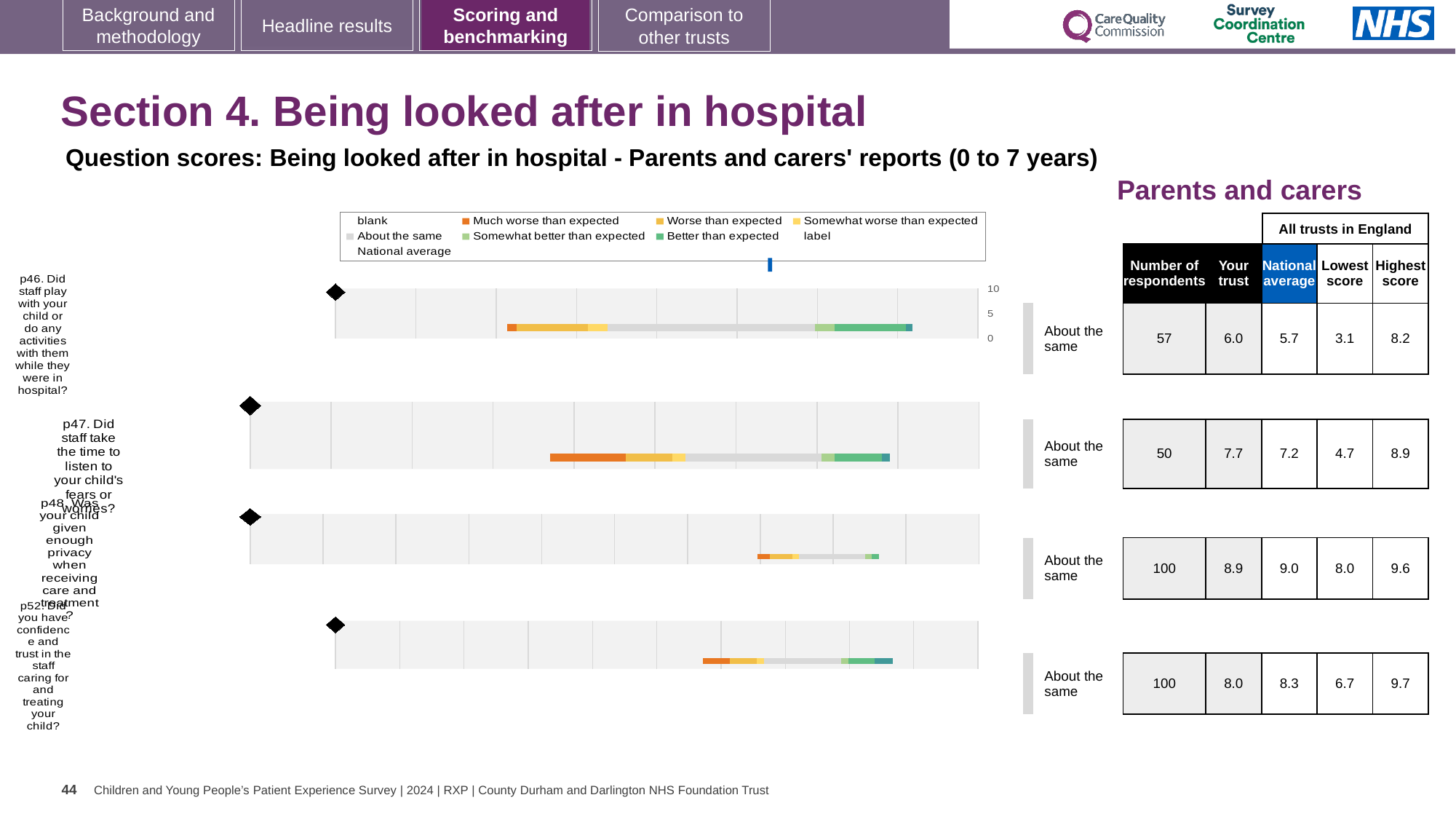
How many questions (p46, p47, p48, p52) have a chart on this slide? 4 For p47, which is larger: the 'Your trust' score or the national average? Your trust How many entries does the chart legend list? 9 What benchmark category is shown next to the chart for every question on this slide? About the same What is the 'Your trust' score for p46 (Did staff play with your child or do any activities with them while they were in hospital?)? 6.0 What is the difference between the highest score and the lowest score for p52 (Did you have confidence and trust in the staff caring for and treating your child?)? 3.0 What colour represents 'Much worse than expected' in the chart legend? orange How many respondents answered p48 (Was your child given enough privacy when receiving care and treatment?)? 100 Which question has the highest 'Your trust' score on this slide? p48 What is the national average score for p47 (Did staff take the time to listen to your child's fears or worries?)? 7.2 What kind of chart is used to show the question scores on this slide? bar chart What is the lowest score among all trusts in England for p52? 6.7